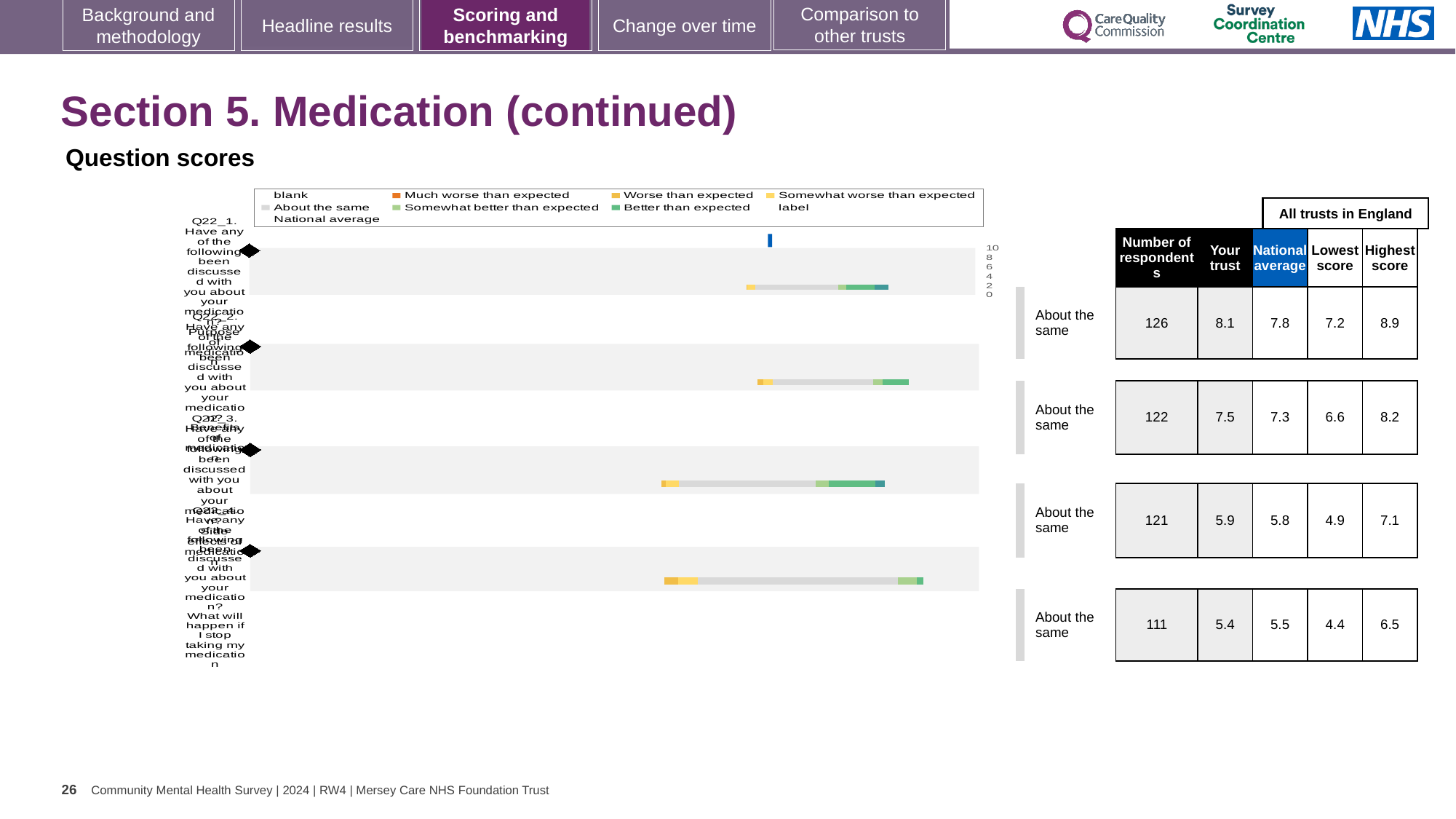
What is the difference between the 'Your trust' score and the national average for the second question row? 0.2 What is the highest score among all trusts in England for the third question row? 7.1 For the fourth (bottom) question row, which is larger: the 'Your trust' score or the national average? National average What benchmark category is shown next to each of the four question rows? About the same How many question rows are plotted in the chart? 4 What is the 'Your trust' score for the first (top) question row? 8.1 What kind of chart is shown on the slide? bar chart Which question row has the highest 'Your trust' score? the first (top) row, 8.1 Which question row has the lowest number of respondents? the fourth (bottom) row, 111 What is the lowest score among all trusts in England for the fourth (bottom) question row? 4.4 What is the national average for the first (top) question row? 7.8 What is the number of respondents for the second question row? 122